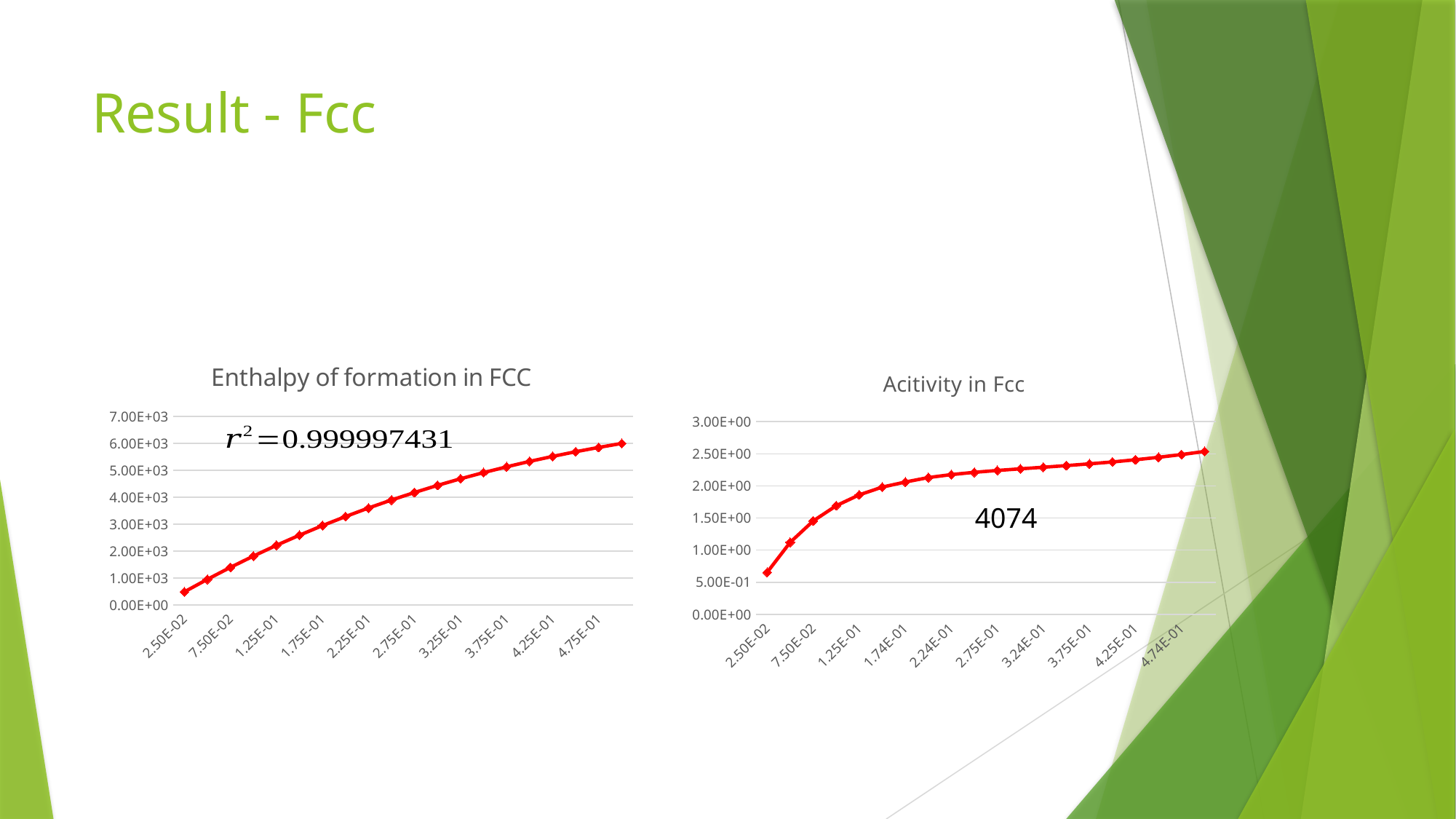
In the 'Acitivity in Fcc' chart, do the values rise or fall along the x axis? rise In the 'Acitivity in Fcc' chart, is the value at x = 2.50E-02 greater or less than 1.00E+00? less In the 'Enthalpy of formation in FCC' chart, do the values rise or fall along the x axis? rise In the 'Acitivity in Fcc' chart, which x value has the higher plotted value, 2.50E-02 or 4.74E-01? 4.74E-01 How many x-axis tick labels are shown on the 'Enthalpy of formation in FCC' chart? 10 What kind of chart is the 'Enthalpy of formation in FCC' chart? line chart In the 'Enthalpy of formation in FCC' chart, is the value at x = 4.75E-01 greater or less than 5.00E+03? greater What r-squared value is printed on the 'Enthalpy of formation in FCC' chart? 0.999997431 What number is annotated inside the plot area of the 'Acitivity in Fcc' chart? 4074 What kind of chart is the 'Acitivity in Fcc' chart? line chart In the 'Enthalpy of formation in FCC' chart, is the value at x = 2.50E-02 greater or less than 1.00E+03? less